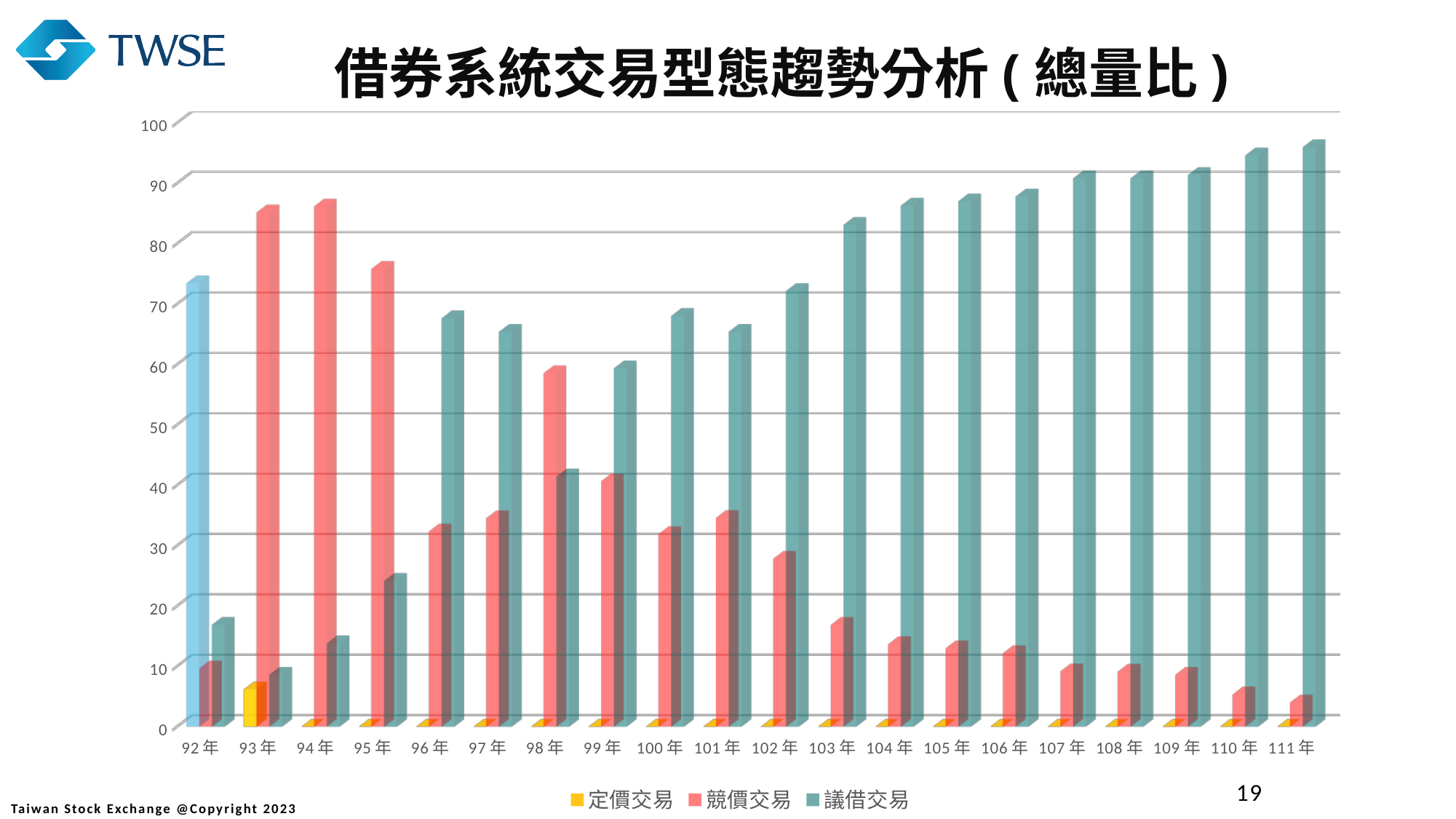
Is the value of 議借交易 for 92年 greater or less than 20? less Is the value of 競價交易 for 93年 greater or less than 80? greater Is the value of 競價交易 for 111年 greater or less than 10? less What kind of chart is shown on the slide? bar chart Which year has the lowest value for 議借交易? 93年 From 103年 to 111年, does the value of 競價交易 rise or fall? fall For 94年, which is larger: 競價交易 or 議借交易? 競價交易 How many year categories are shown on the x axis? 20 For 103年, which is larger: 競價交易 or 議借交易? 議借交易 How many series does the legend list? 3